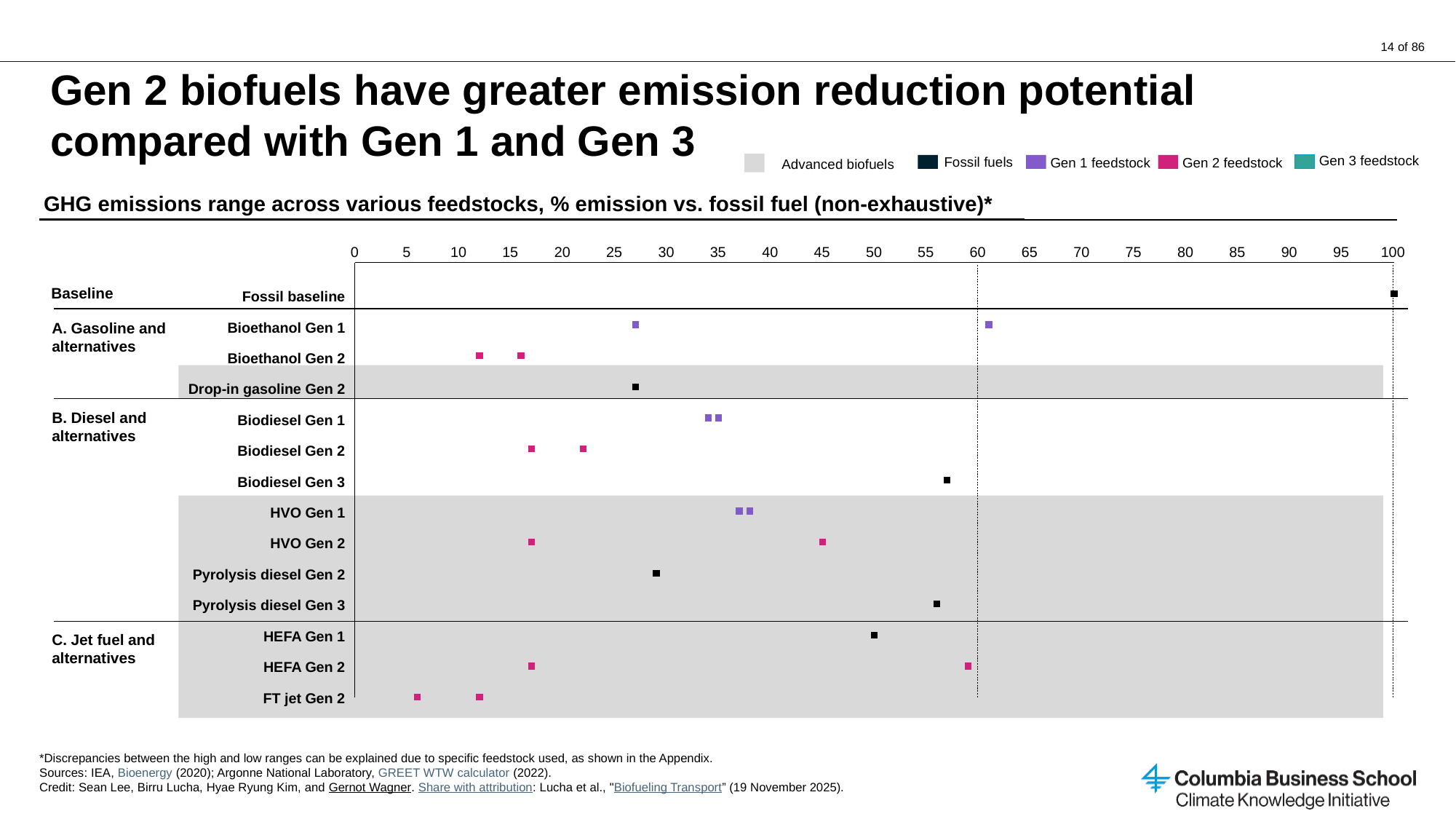
Are the values for FT jet Gen 2 greater or less than 15? less What value is plotted for Fossil baseline? 100 Is the value for Drop-in gasoline Gen 2 greater or less than 25? greater Are the values for Bioethanol Gen 2 greater or less than 20? less How many entries does the legend list? 5 Which has higher plotted values, Biodiesel Gen 1 or Biodiesel Gen 2? Biodiesel Gen 1 What kind of chart is shown on the slide? Scatter (dot) chart How many feedstock entries (rows) are plotted on the chart, including the fossil baseline? 14 Excluding the fossil baseline, which feedstock has the lowest plotted value? FT jet Gen 2 What is the title of the chart? GHG emissions range across various feedstocks, % emission vs. fossil fuel (non-exhaustive)* Which legend entry is shown in pink/magenta? Gen 2 feedstock